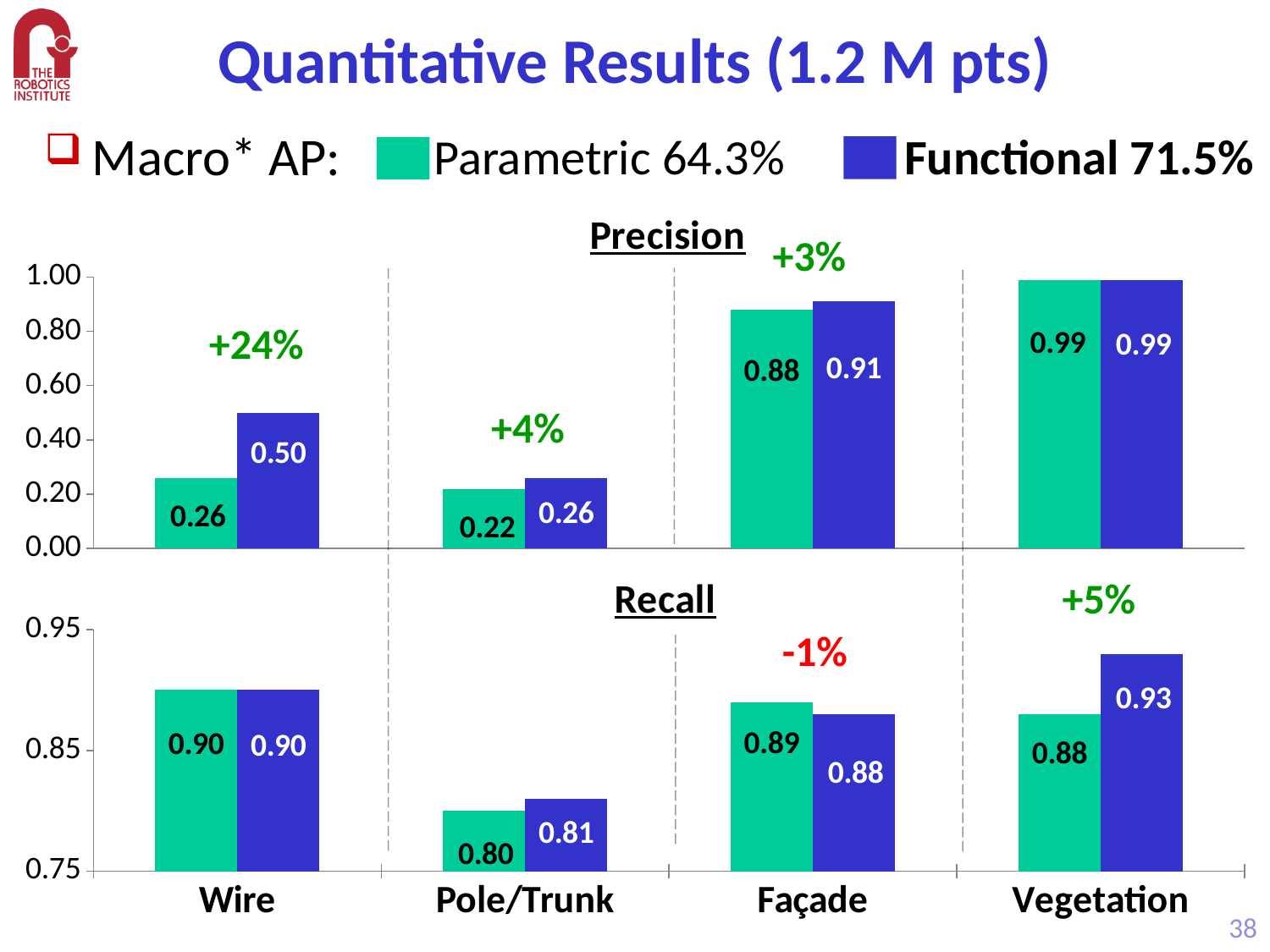
In the Precision chart, what is the Parametric precision for Pole/Trunk? 0.22 What type of chart is the Recall chart? Bar chart In the Recall chart, which category has the lowest Functional recall? Pole/Trunk In the Precision chart, what is the difference between the Functional and Parametric precision for Wire? 0.24 In the Precision chart, which category has the lowest Parametric precision? Pole/Trunk In the Recall chart, what is the Functional recall for Vegetation? 0.93 In the Precision chart, what is the Functional precision for Wire? 0.50 In the Recall chart, what is the difference between the Functional and Parametric recall for Vegetation? 0.05 How many categories are shown on the x axis of the Precision chart? 4 In the Recall chart, what is the Parametric recall for Façade? 0.89 In the Precision chart, what percentage improvement is annotated above the Wire bars? +24% In the Recall chart, which is larger for Façade: the Parametric recall or the Functional recall? Parametric